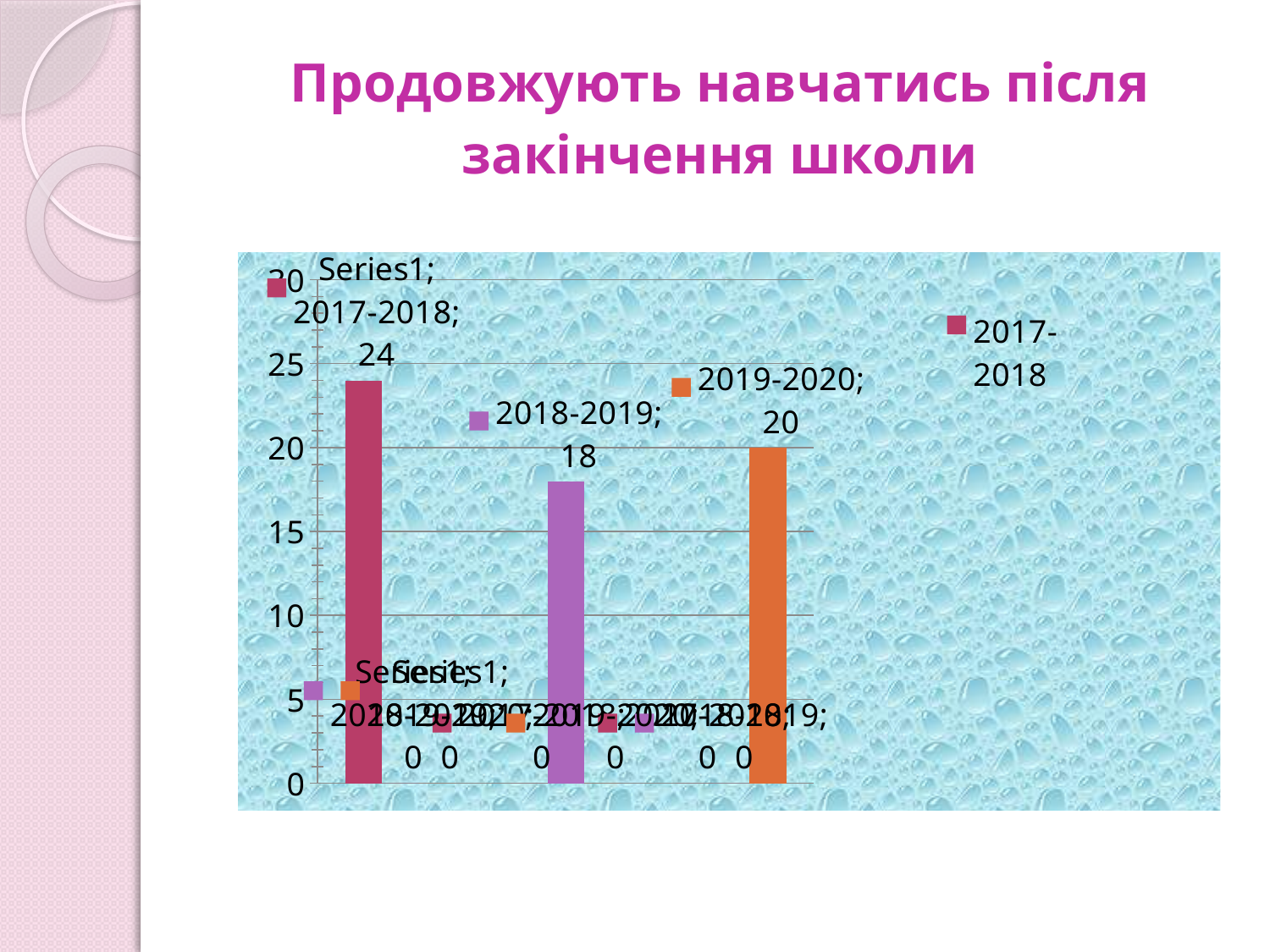
Which is larger, the value for 2018-2019 or the value for 2019-2020? 2019-2020 What is the value for 2019-2020? 20 Which school year has the highest value? 2017-2018 Which school year has the lowest value? 2018-2019 What is the title of the slide containing the chart? Продовжують навчатись після закінчення школи What kind of chart is shown on the slide? bar chart What is the value for 2018-2019? 18 What is the value for 2017-2018? 24 What is the difference between the values for 2017-2018 and 2018-2019? 6 What is the difference between the values for 2019-2020 and 2018-2019? 2 What colour is the bar for 2019-2020? orange Is the value for 2017-2018 greater or less than 20? greater